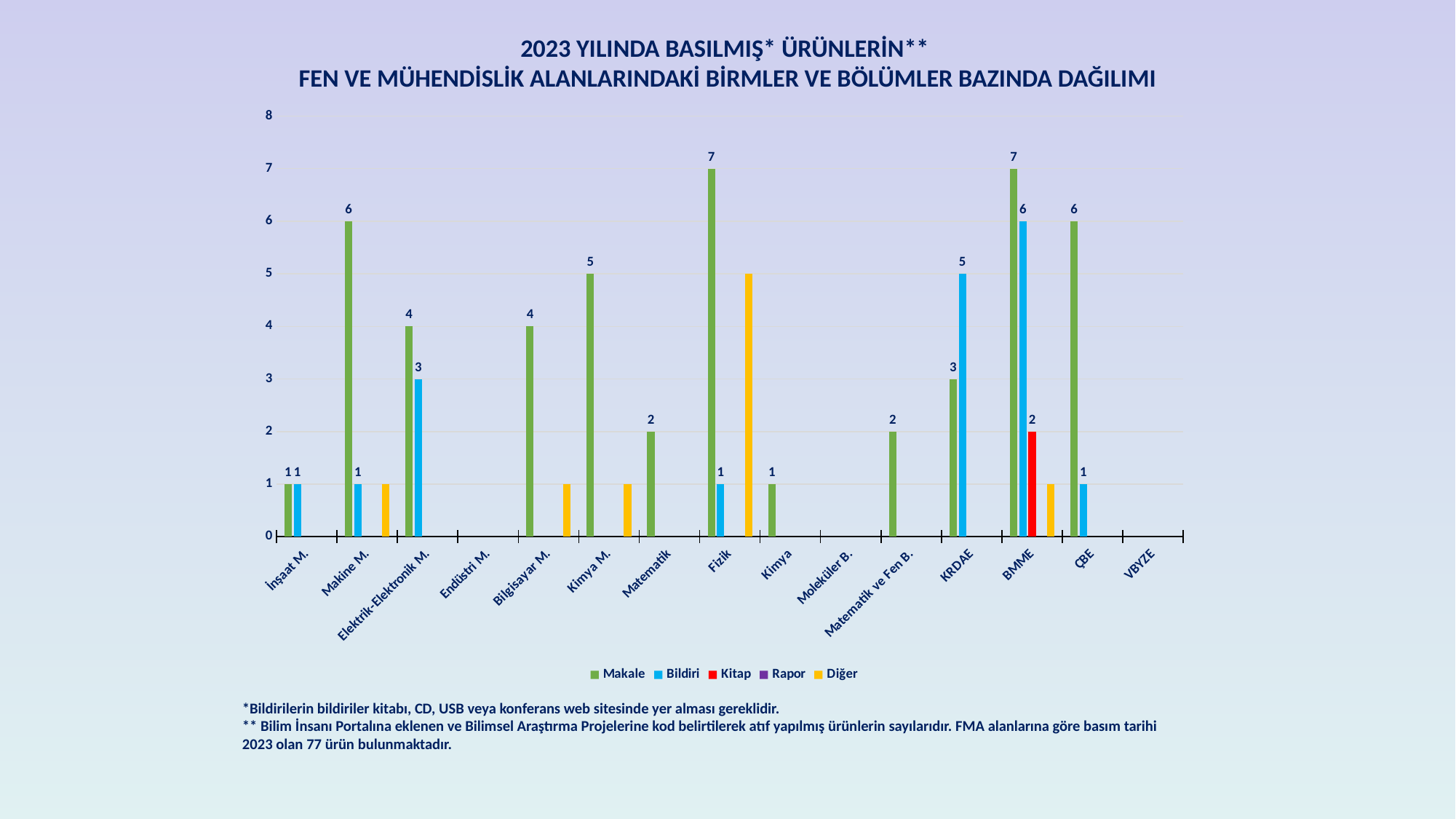
What is the Bildiri value for BMME? 6 What is the Bildiri value for KRDAE? 5 For Elektrik-Elektronik M., which is larger: the Makale value or the Bildiri value? Makale What is the Makale value for Fizik? 7 What is the Kitap value for BMME? 2 How many categories are shown on the x axis? 15 What is the difference between the Makale and Bildiri values for Makine M.? 5 What kind of chart is shown on the slide? bar chart What colour represents the Kitap series in the legend? red Which category has the highest Bildiri value? BMME Is the Diğer value for Fizik greater or less than 4? greater How many series does the legend list? 5